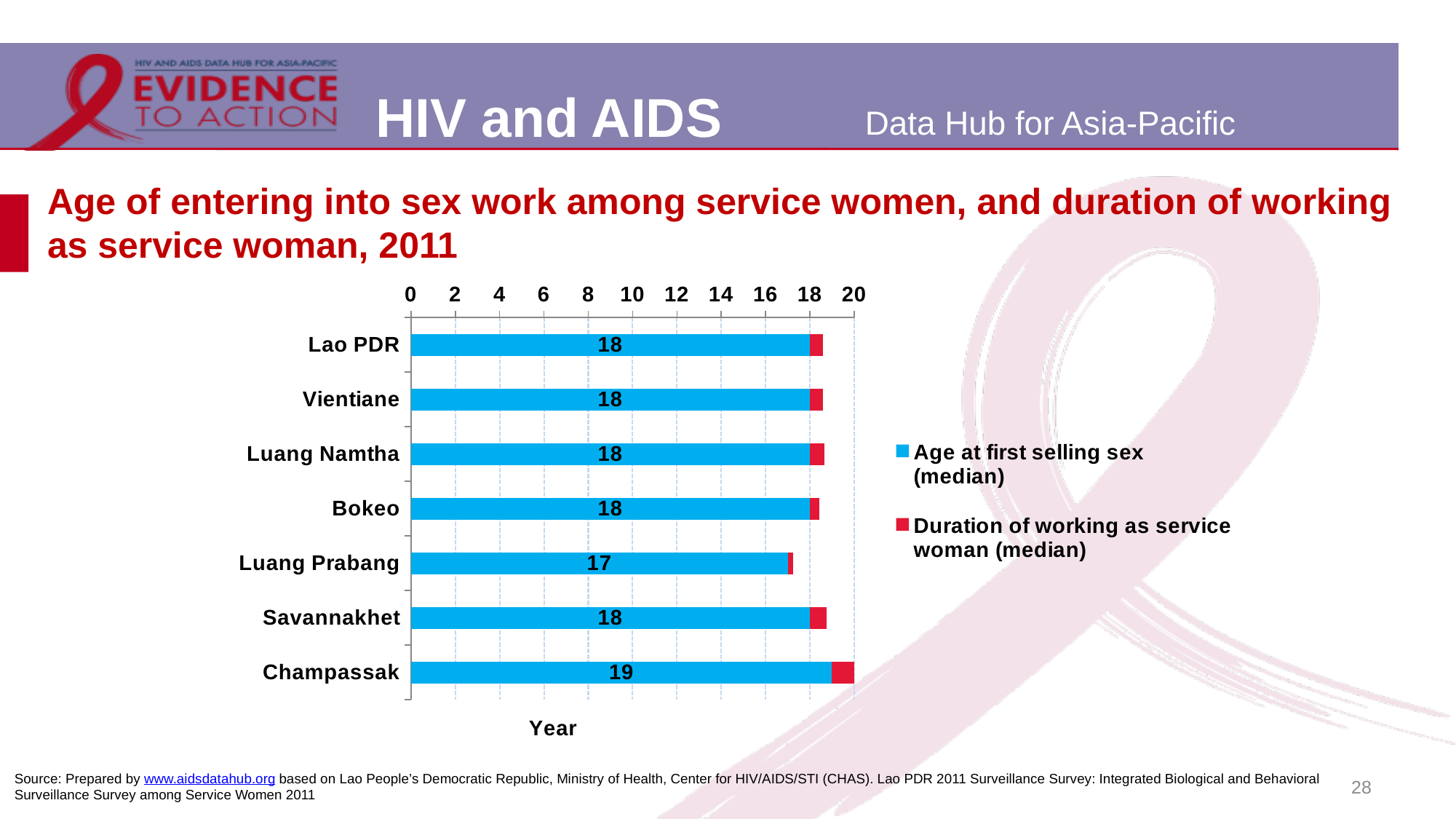
What is the difference in median age at first selling sex between Champassak and Luang Prabang? 2 What is the median age at first selling sex for Lao PDR? 18 What is the title of the horizontal axis? Year How many provinces or areas are shown on the chart? 7 How many series does the legend list? 2 What is the median age at first selling sex for Luang Prabang? 17 What is the median age at first selling sex for Savannakhet? 18 Which has a higher median age at first selling sex, Champassak or Luang Prabang? Champassak What kind of chart is shown on the slide? Stacked bar chart Which province has the lowest median age at first selling sex? Luang Prabang Which province has the highest median age at first selling sex? Champassak What is the median age at first selling sex for Champassak? 19